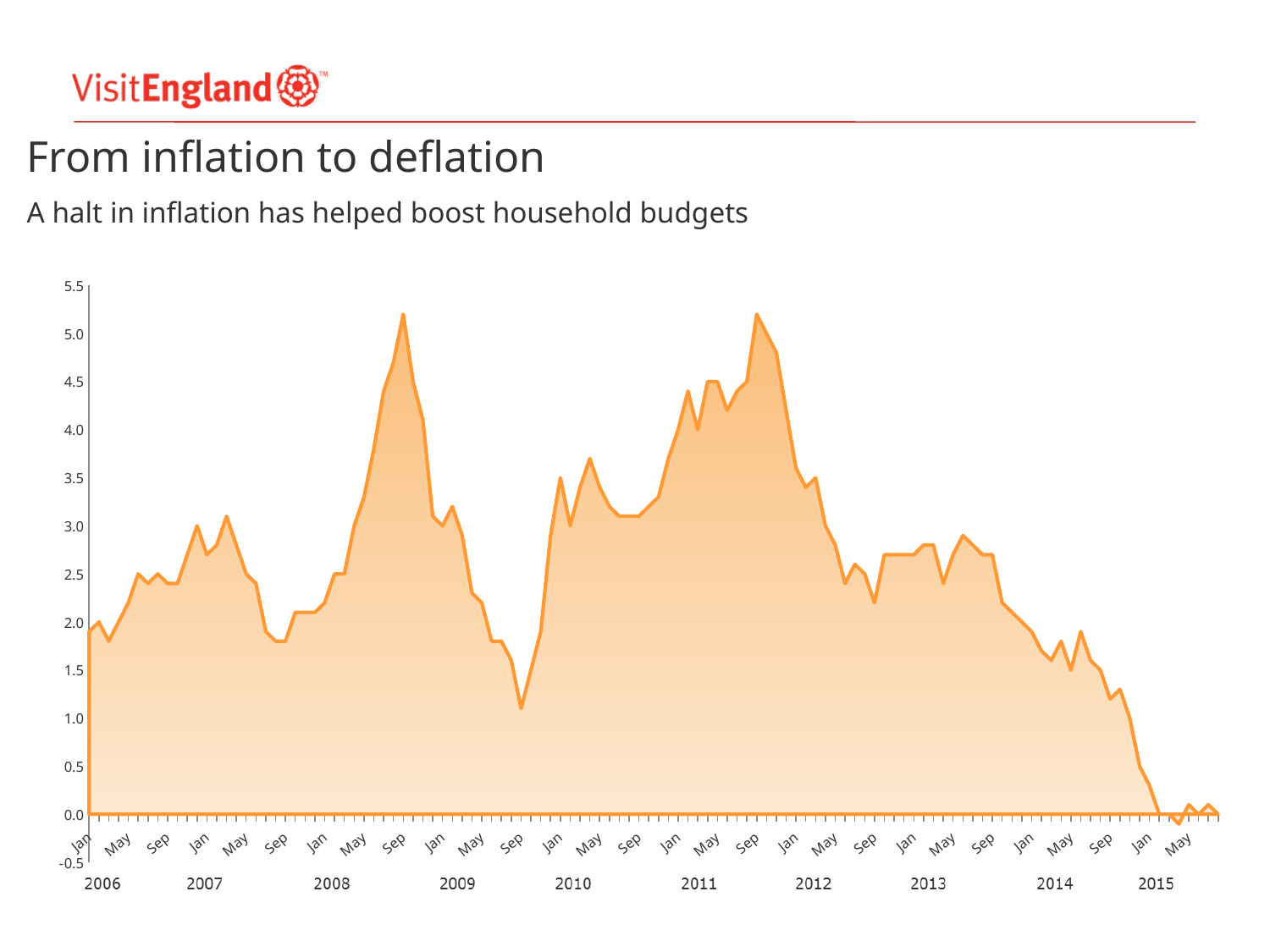
How many years are labelled along the x axis of the chart? 10 Is the value for May 2015 greater or less than 0.5? less Which is higher, the value for Sep 2008 or the value for Sep 2009? Sep 2008 Is the value for Sep 2009 greater or less than 1.5? less What is the highest value shown on the y axis of the chart? 5.5 What is the title of the slide containing the chart? From inflation to deflation Is the value for Jan 2012 greater or less than 3.0? greater In which year does the chart reach its lowest values? 2015 Do the values rise or fall from Jan 2014 to May 2015? fall What kind of chart is shown on the slide? Area chart